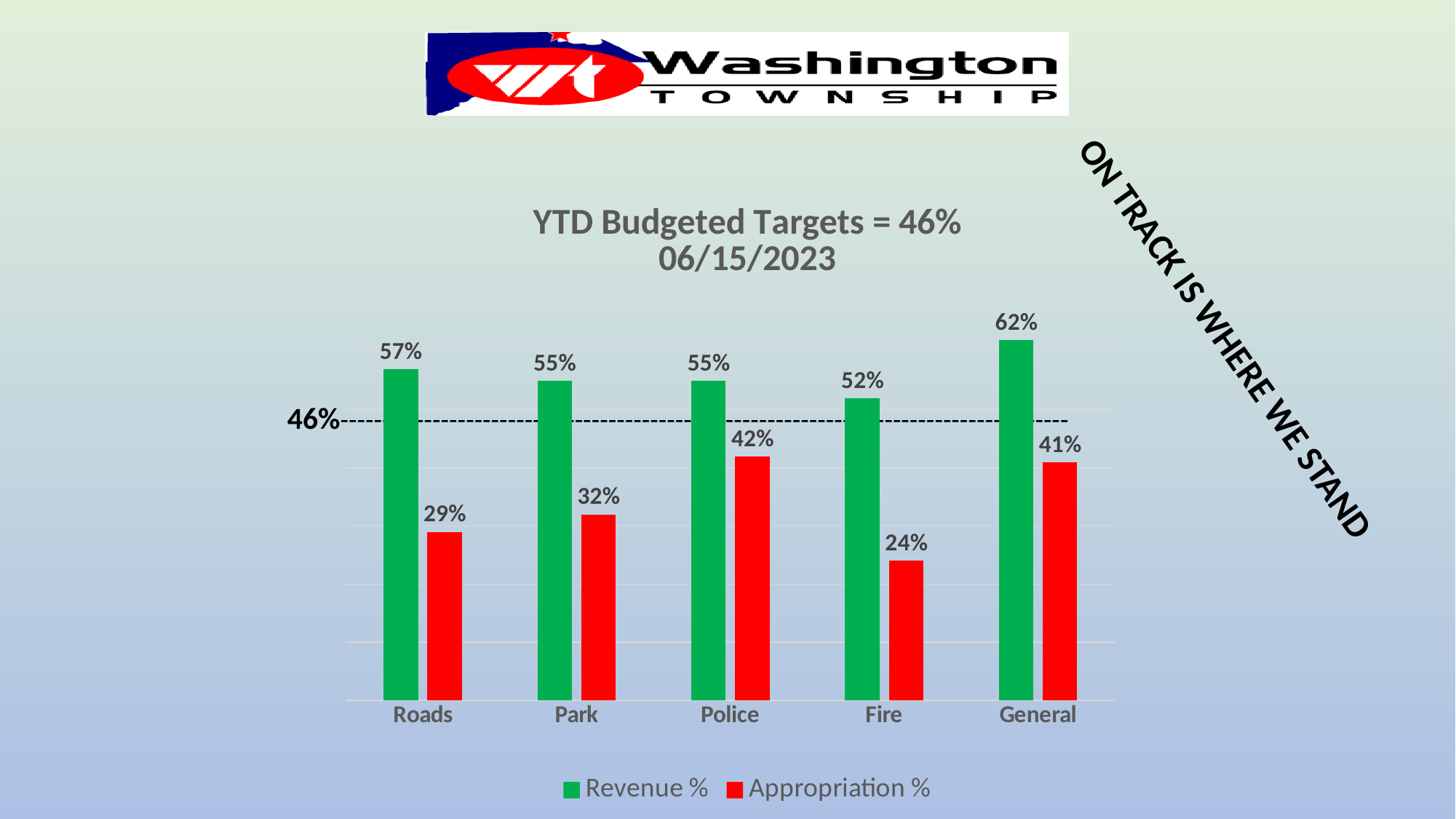
What kind of chart is shown on the slide? bar chart What is the Revenue % value for Roads? 57% Is the Revenue % for Fire greater or less than 46%? greater Which is larger, the Appropriation % for General or the Appropriation % for Roads? General Which category has the highest Revenue %? General Which category has the lowest Appropriation %? Fire What is the difference between the Revenue % and Appropriation % for Park? 23% What is the Appropriation % value for Fire? 24% What is the Appropriation % value for Police? 42% How many series does the legend list? 2 How many categories are shown on the x axis? 5 What is the title of the chart? YTD Budgeted Targets = 46% 06/15/2023